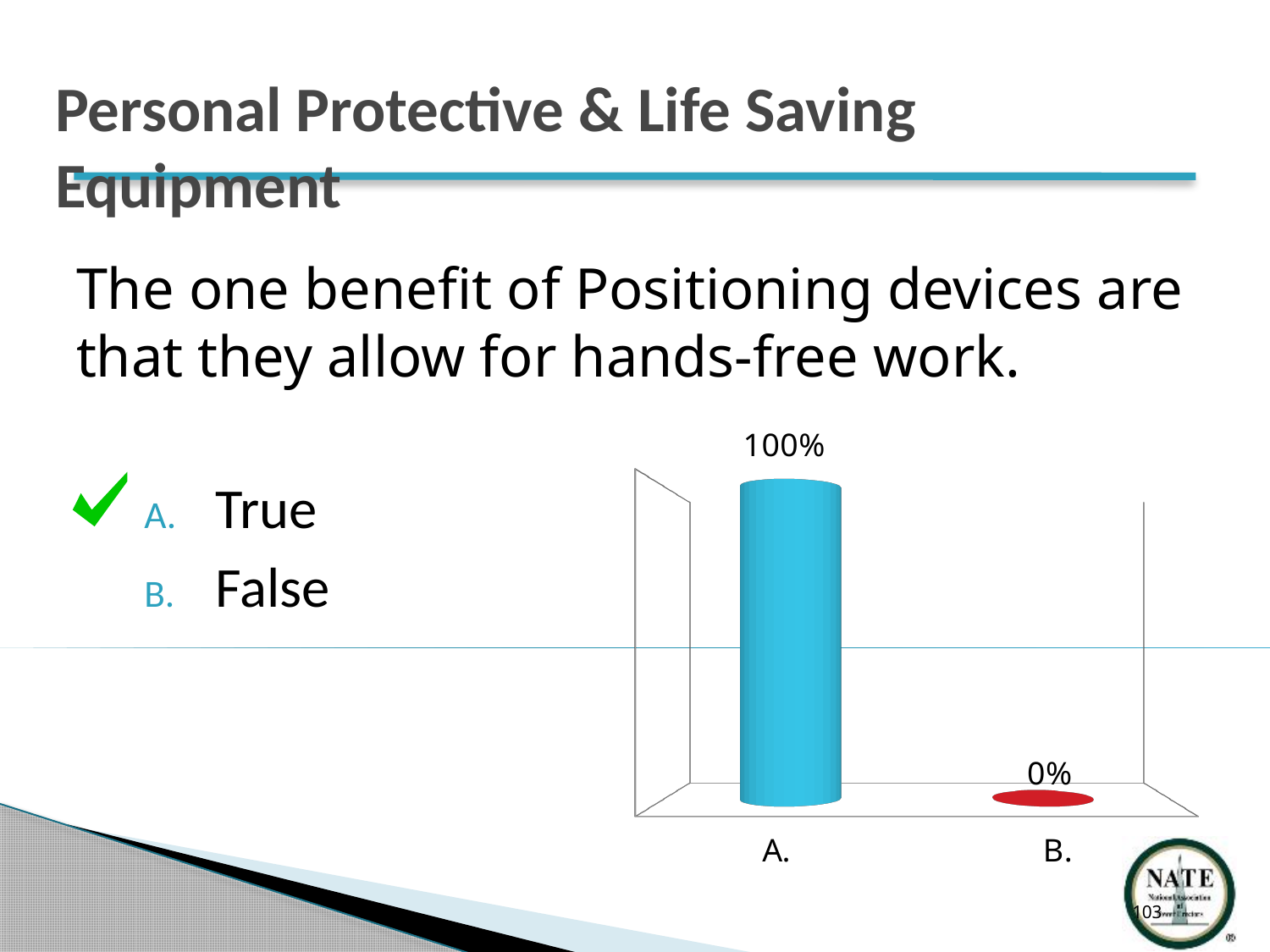
What kind of chart is shown on the slide? bar chart What is the value for category B.? 0% Do the values rise or fall from A. to B.? fall Which is larger, the value for A. or the value for B.? A. How many categories are shown in the chart? 2 Which category has the lowest value? B. What colour is the bar for category A.? blue What is the difference between the values for A. and B.? 100% Which category has the highest value? A. What is the value for category A.? 100% What is the total of the values for A. and B.? 100% What colour is the bar for category B.? red